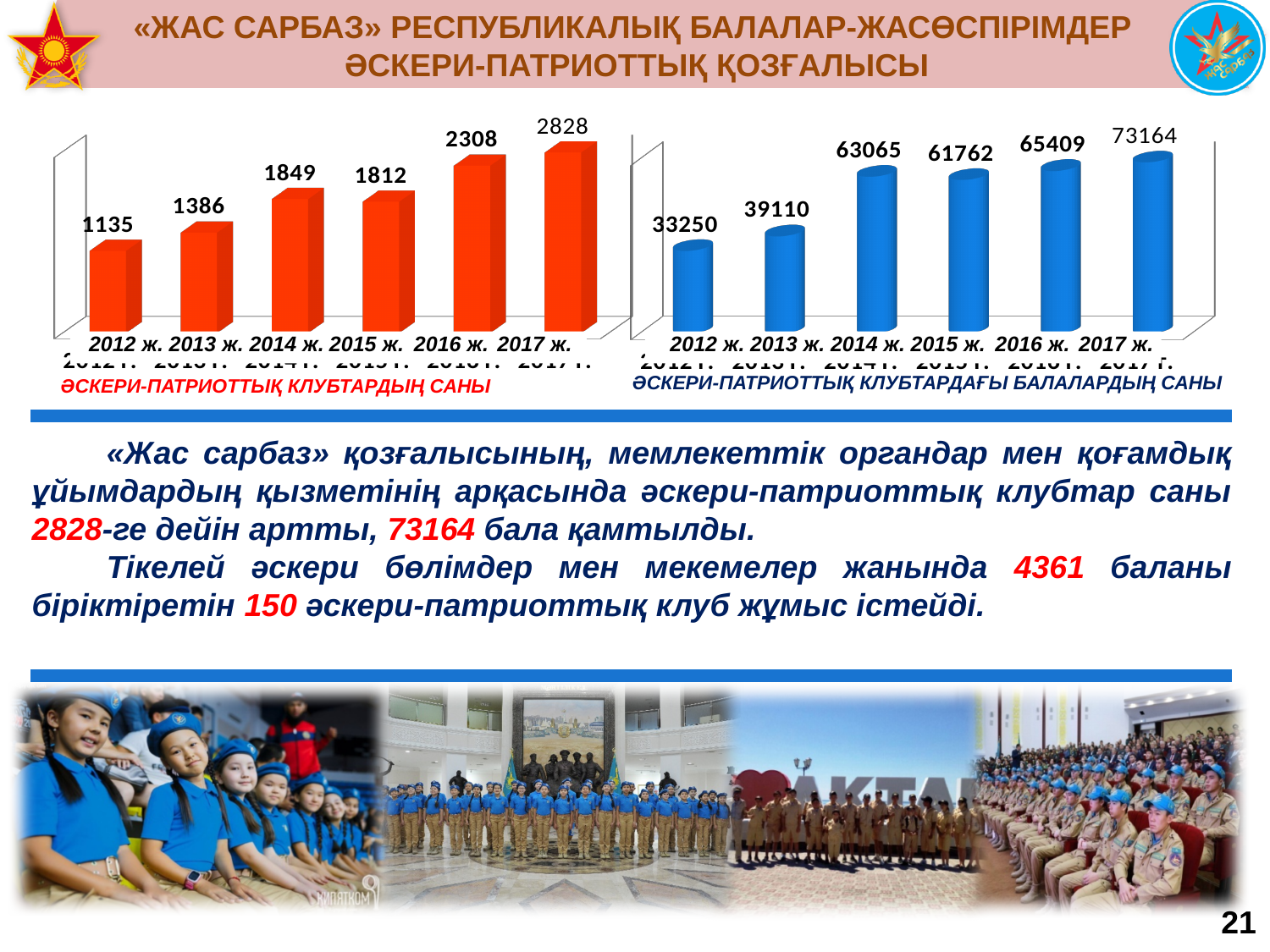
On the right chart (number of children in military-patriotic clubs), what is the value for 2013 ж.? 39110 On the left chart, what is the difference between the values for 2017 ж. and 2016 ж.? 520 What kind of chart is the right chart? Bar chart On the right chart, what is the value for 2017 ж.? 73164 On the right chart, do the values generally rise or fall from 2012 ж. to 2017 ж.? Rise On the left chart, which year has the highest value? 2017 ж. On the left chart (number of military-patriotic clubs), what is the value for 2014 ж.? 1849 On the left chart, which year has the lowest value? 2012 ж. On the right chart, which year has the lowest value? 2012 ж. On the right chart, what is the difference between the values for 2014 ж. and 2015 ж.? 1303 On the left chart, which is larger: the value for 2014 ж. or 2015 ж.? 2014 ж. On the left chart, how many years are shown? 6